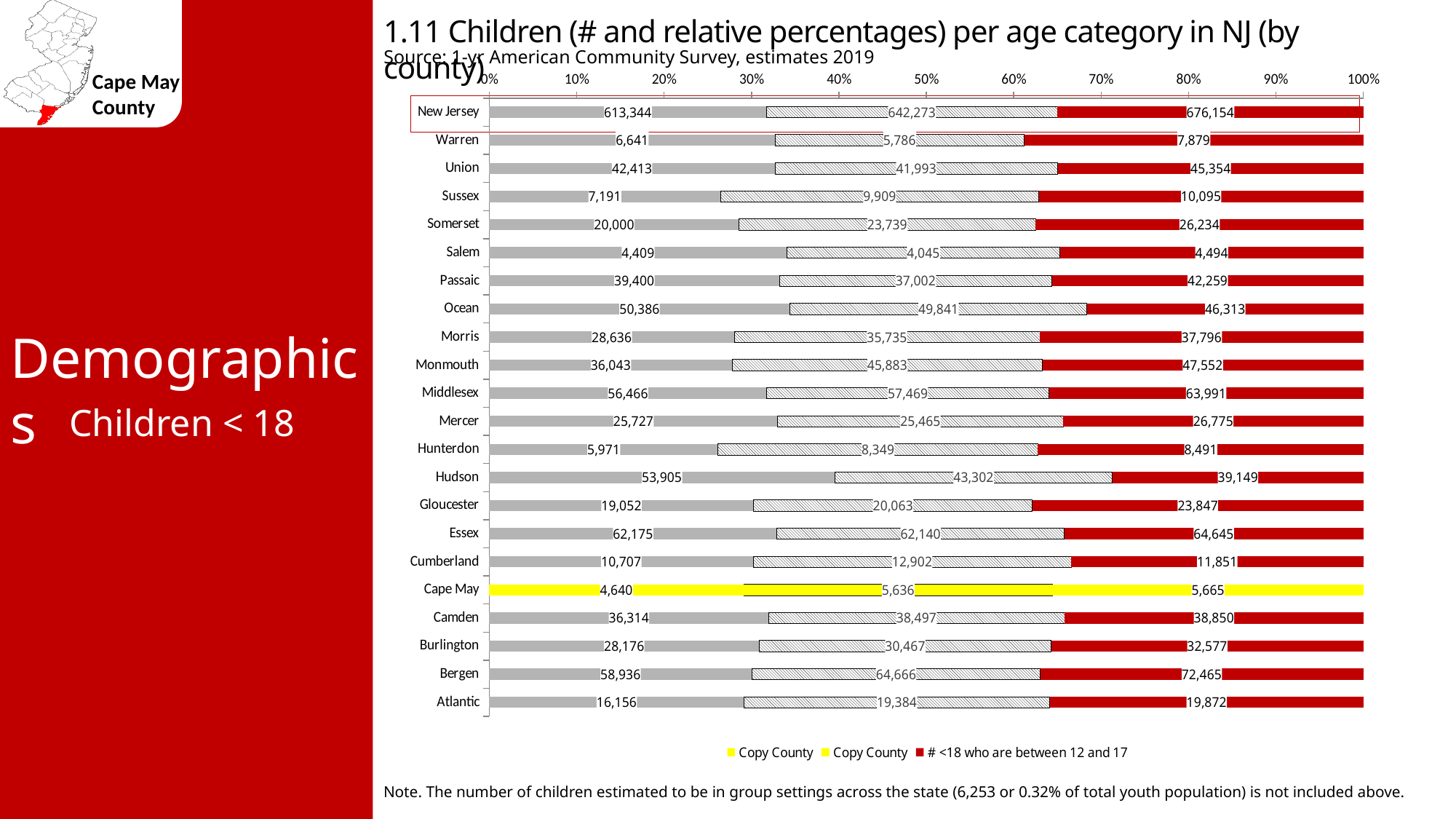
What is the value of the '# <18 who are between 12 and 17' segment for New Jersey? 676,154 What is the value of the '# <18 who are between 12 and 17' segment for Cape May? 5,665 What is the total of the three segments for Cape May? 15,941 What kind of chart is shown on the slide? bar chart How many series does the chart legend list? 3 What is the difference between Cape May's '# <18 who are between 12 and 17' value (5,665) and its first segment value (4,640)? 1,025 Which is larger: the first segment value for Hudson or the first segment value for Bergen? Bergen Is the share of Hudson's first (leftmost) segment greater or less than 30%? greater What is the value of the first (leftmost) segment for Cape May? 4,640 Among the counties (excluding the New Jersey row), which has the largest '# <18 who are between 12 and 17' value? Bergen How many counties/rows are listed on the chart's vertical axis? 22 Among the counties (excluding the New Jersey row), which has the smallest '# <18 who are between 12 and 17' value? Salem